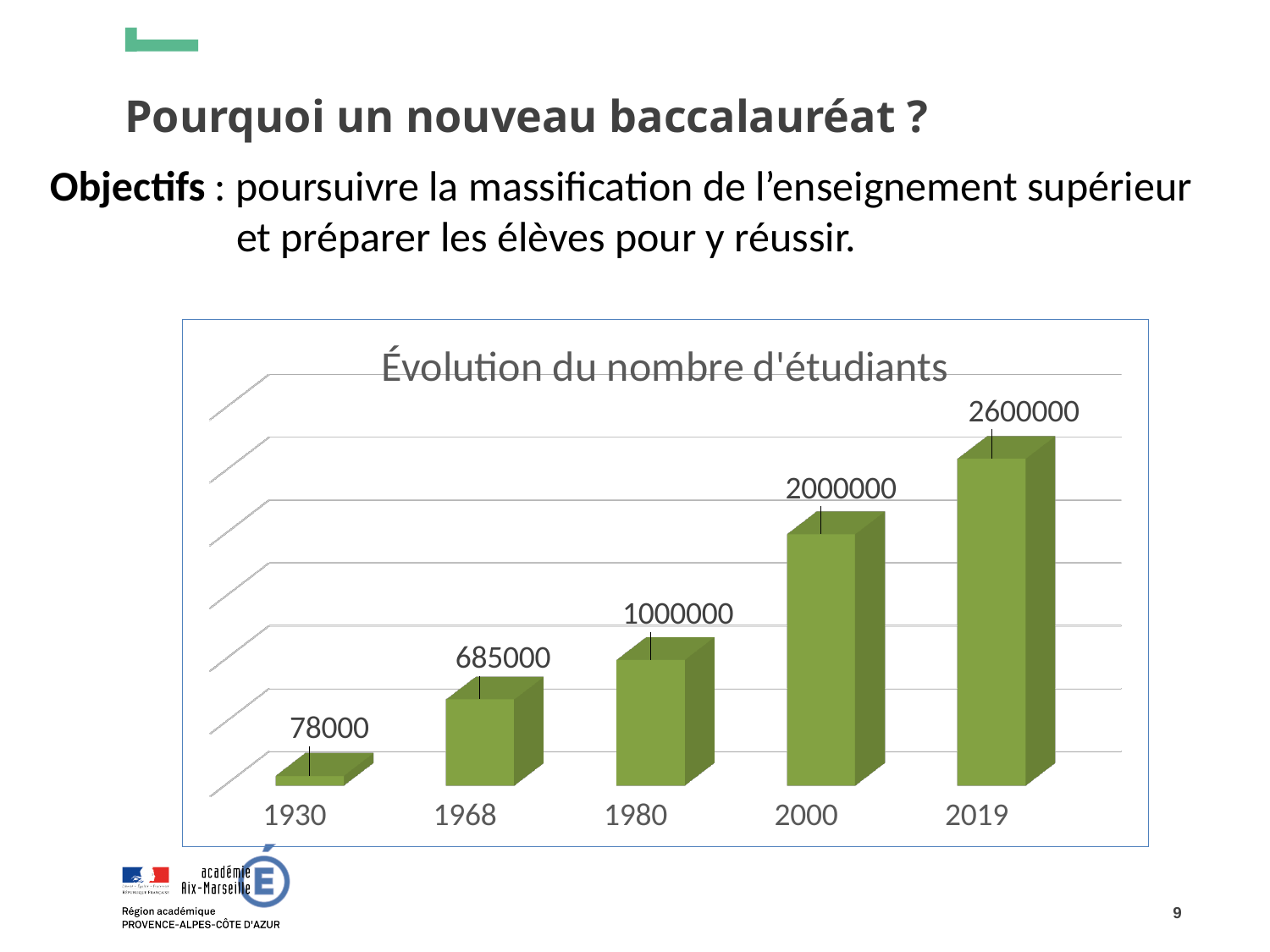
What is the number of students shown for 2000? 2000000 What kind of chart is shown on the slide? bar chart What is the number of students shown for 1930? 78000 Which year has the lowest number of students? 1930 How many years are shown on the x axis of the chart? 5 What is the difference between the number of students in 1980 and in 1968? 315000 Which year has the highest number of students? 2019 What is the difference between the number of students in 2019 and in 2000? 600000 Do the values rise or fall from 1930 to 2019? rise What is the number of students shown for 1968? 685000 What is the number of students shown for 2019? 2600000 Which is larger, the value for 1980 or the value for 1968? 1980